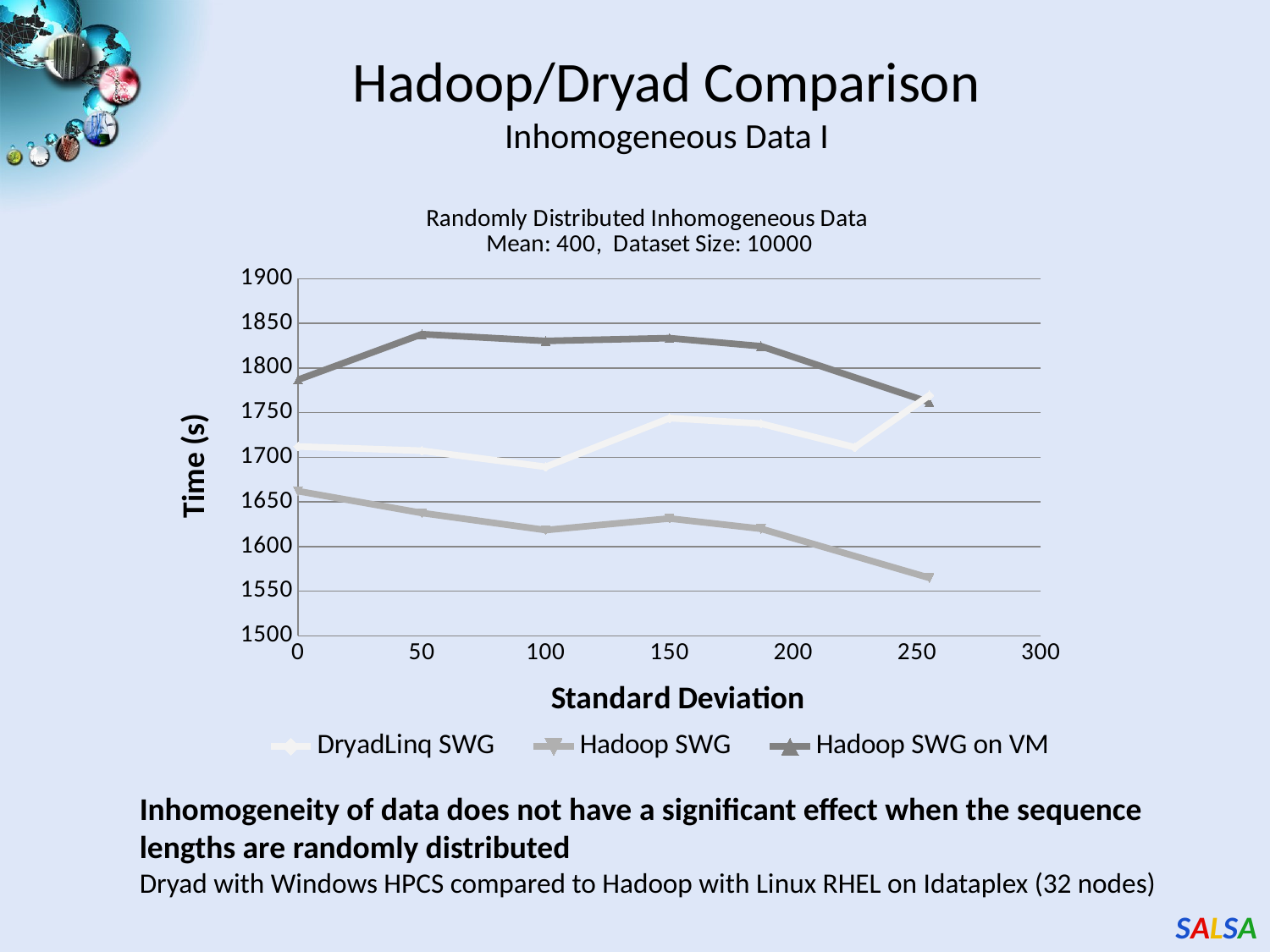
Is the value for Hadoop SWG at Standard Deviation 0 greater or less than 1650? greater Is the value for DryadLinq SWG at Standard Deviation 100 greater or less than 1700? less What is the label of the y axis? Time (s) Does the Hadoop SWG line generally rise or fall as Standard Deviation increases? fall Is the value for Hadoop SWG on VM at Standard Deviation 0 greater or less than 1800? less How many series does the legend list? 3 At Standard Deviation 0, which series has the larger Time (s): DryadLinq SWG or Hadoop SWG? DryadLinq SWG Which series has the highest Time (s) values across the chart? Hadoop SWG on VM What kind of chart is shown on the slide? Line chart Which series has the lowest Time (s) values across the chart? Hadoop SWG What is the label of the x axis? Standard Deviation